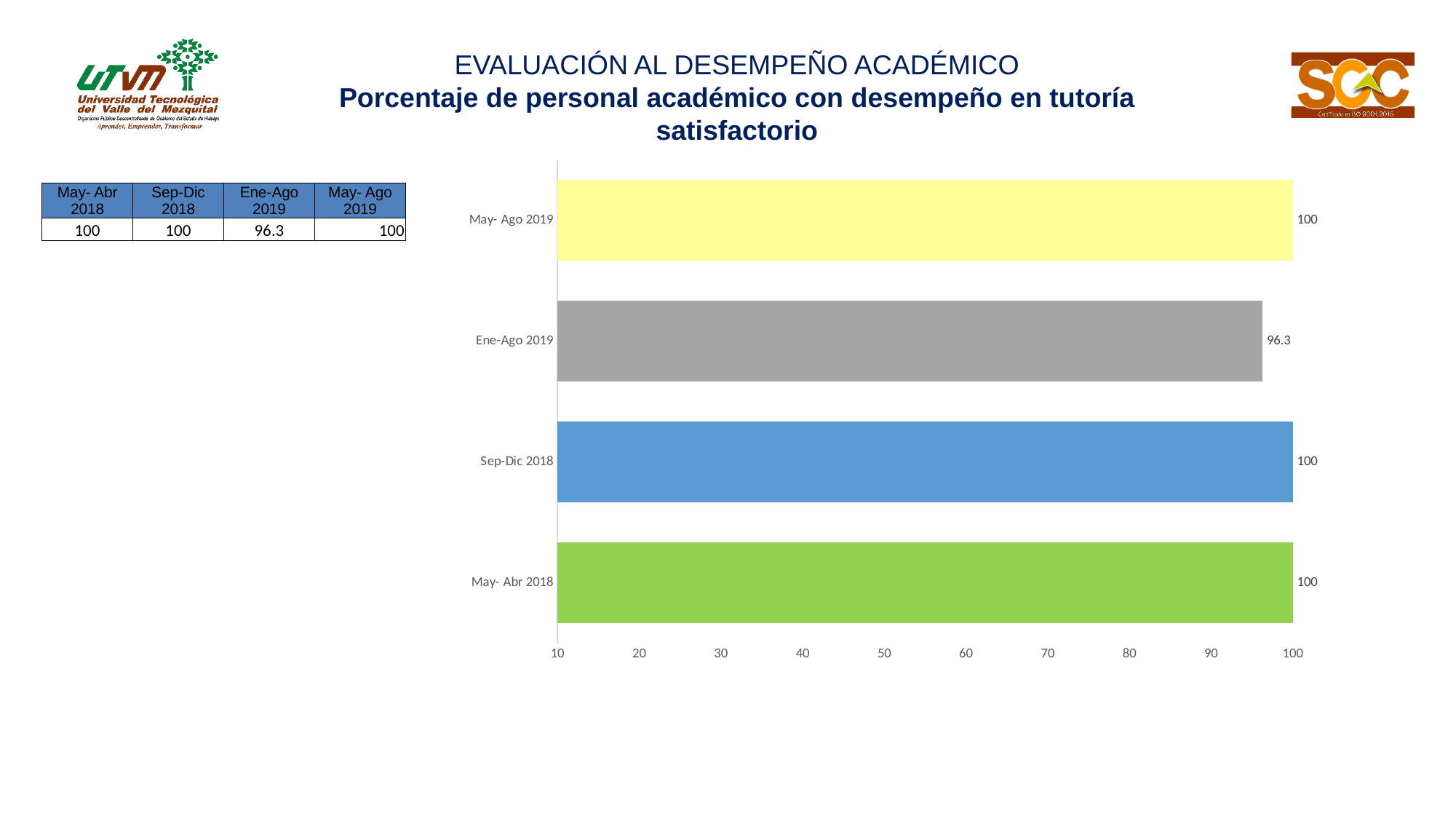
What colour is the bar for Ene-Ago 2019? gray What is the value for Ene-Ago 2019? 96.3 Is the value for Ene-Ago 2019 greater or less than 90? greater What is the difference between the values for Sep-Dic 2018 and Ene-Ago 2019? 3.7 What is the value for Sep-Dic 2018? 100 What is the value for May- Abr 2018? 100 What is the highest tick value shown on the horizontal axis? 100 Which is larger, the value for May- Ago 2019 or the value for Ene-Ago 2019? May- Ago 2019 How many periods are shown in the chart? 4 What kind of chart is shown on the slide? bar chart What is the value for May- Ago 2019? 100 Which period has the lowest value? Ene-Ago 2019